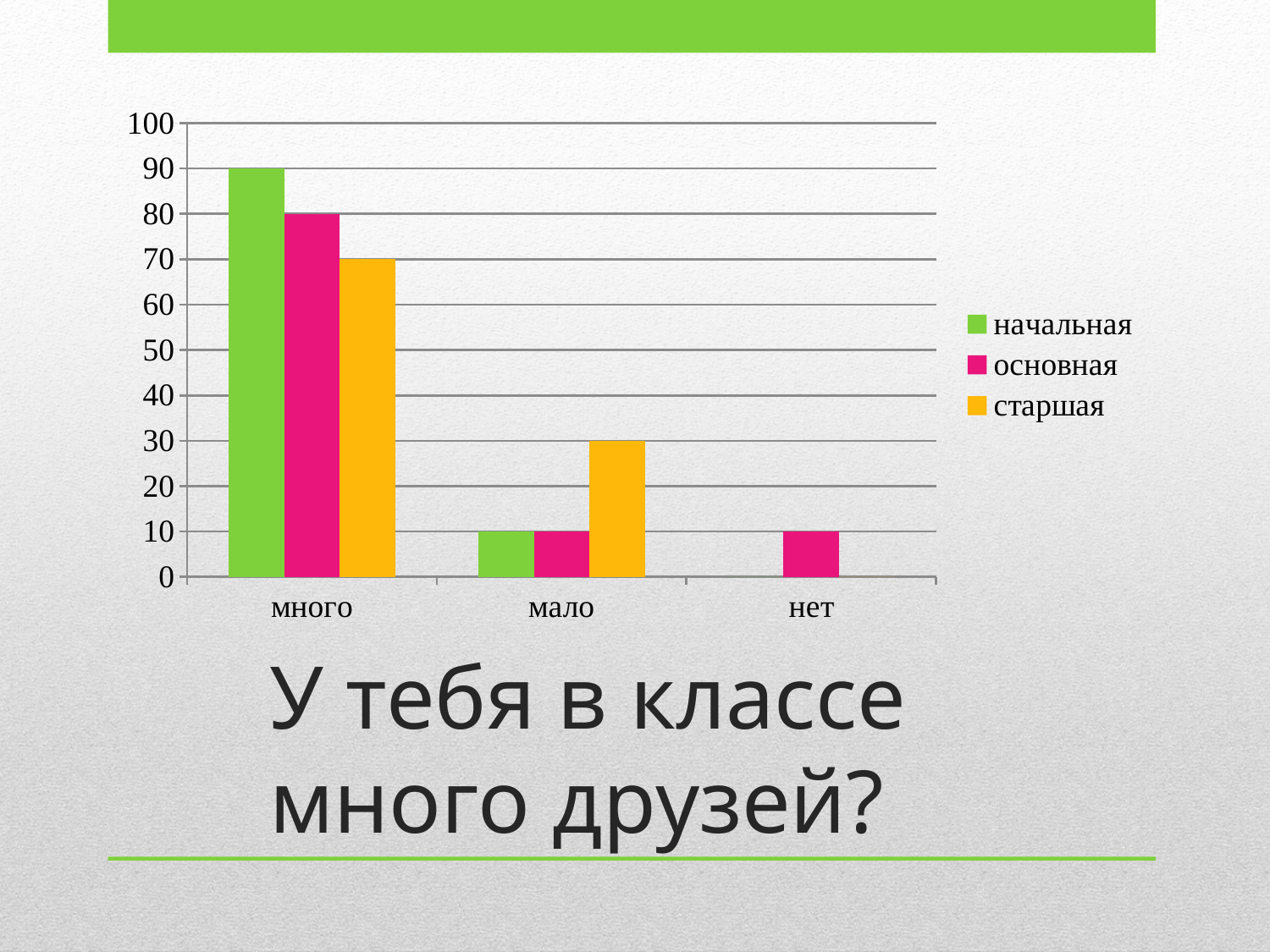
Which series has the lowest value in the много category? старшая Is the value for основная in the много category greater or less than 50? greater Which is larger: старшая in мало or основная in мало? старшая in мало What is the value for старшая in the мало category? 30 How many categories are shown on the x axis? 3 How many series does the legend list? 3 What is the value for основная in the нет category? 10 What colour represents the старшая series? yellow What is the difference between the начальная and старшая values in the много category? 20 Which series has the highest value in the много category? начальная What is the value for начальная in the много category? 90 What kind of chart is shown on the slide? bar chart